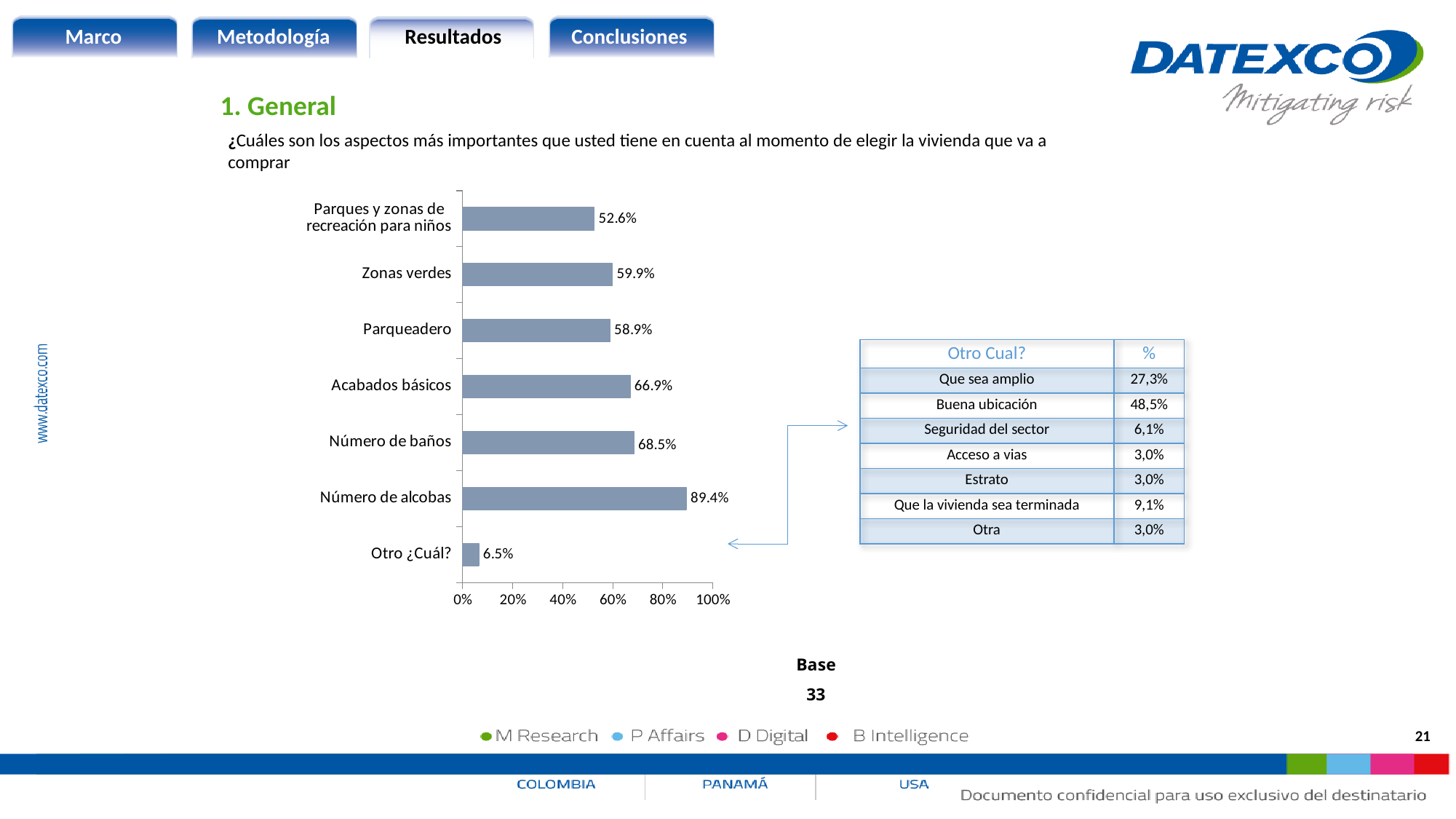
What is the value for Número de alcobas? 89.4% What is the value for Otro ¿Cuál?? 6.5% What is the value for Parqueadero? 58.9% Which is larger, Zonas verdes or Parques y zonas de recreación para niños? Zonas verdes Which category has the lowest value? Otro ¿Cuál? Is the value for Acabados básicos greater or less than 60%? greater What kind of chart is shown on the slide? bar chart What is the maximum value shown on the x axis of the chart? 100% How many categories are shown in the bar chart? 7 What is the difference between Acabados básicos and Parqueadero? 8.0% Which category has the highest value? Número de alcobas What is the difference between Número de alcobas and Número de baños? 20.9%